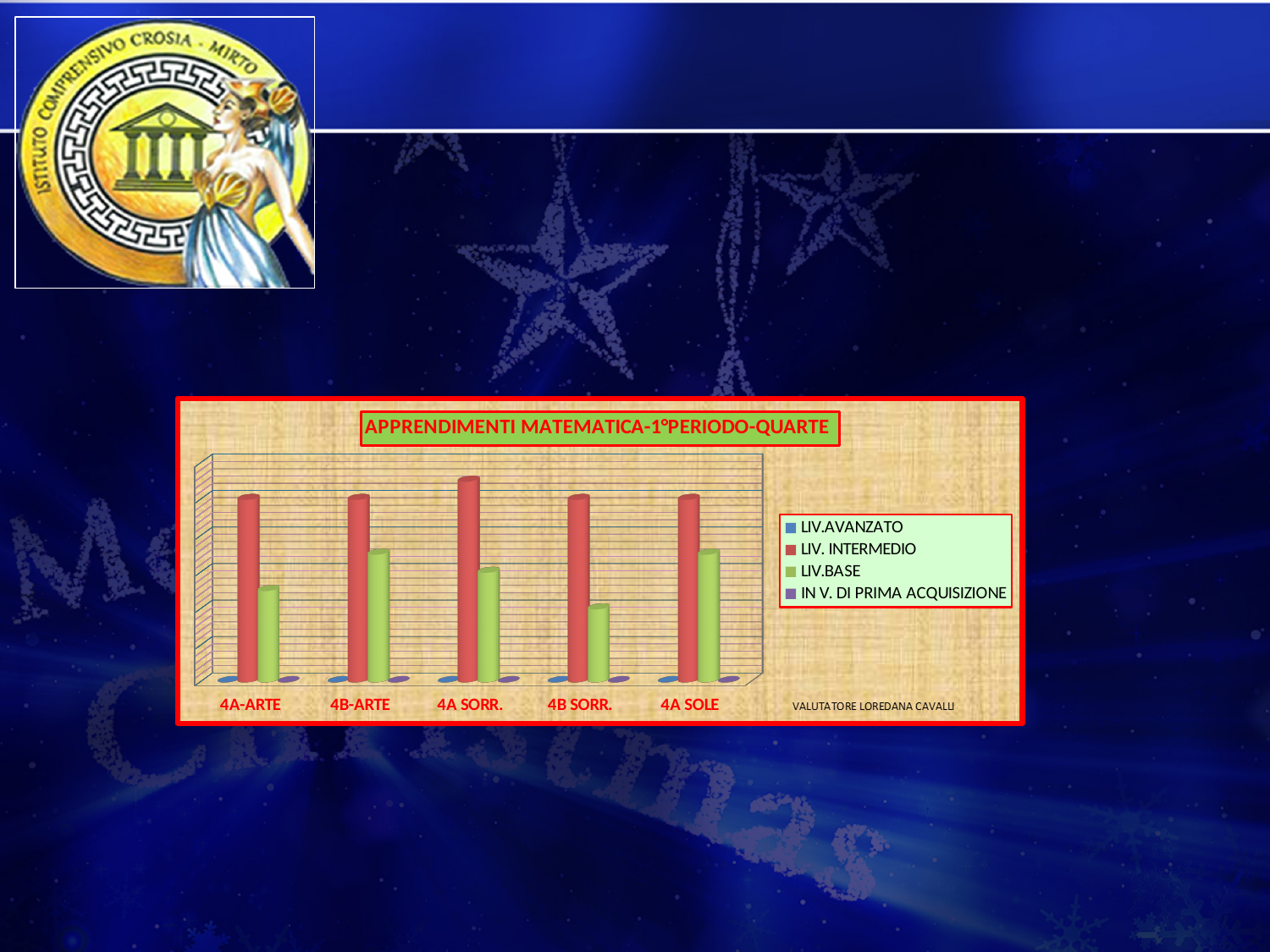
For the class 4A SOLE, which series has the taller bar: LIV. INTERMEDIO or LIV.BASE? LIV. INTERMEDIO What kind of chart is shown on the slide? bar chart Which class has the highest LIV. INTERMEDIO bar? 4A SORR. For LIV.BASE, which is larger: 4A-ARTE or 4B-ARTE? 4B-ARTE For LIV.BASE, which is larger: 4A SORR. or 4B SORR.? 4A SORR. How many series does the chart's legend list? 4 Which colour represents LIV.BASE in the chart's legend? green How many classes (categories) are shown on the x axis of the chart? 5 What is the title of the chart? APPRENDIMENTI MATEMATICA-1°PERIODO-QUARTE Which class has the lowest LIV.BASE bar? 4B SORR.